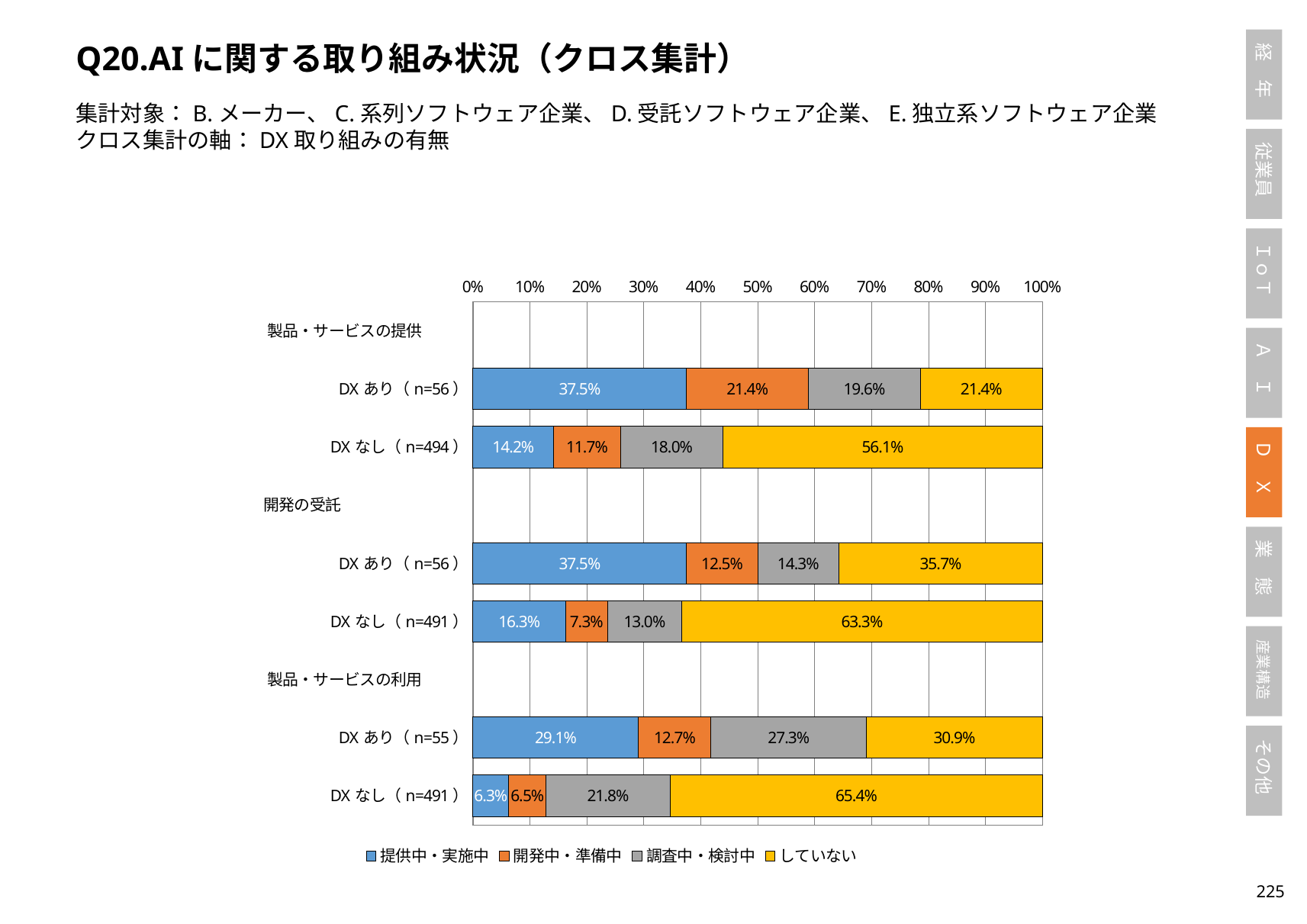
In the 開発の受託 group, what is the 開発中・準備中 value for DX あり (n=56)? 12.5% In the 製品・サービスの提供 group, what is the していない value for DX なし (n=494)? 56.1% In the 製品・サービスの提供 group, what is the 提供中・実施中 value for DX あり (n=56)? 37.5% In the 製品・サービスの利用 group, what is the 調査中・検討中 value for DX あり (n=55)? 27.3% What kind of chart is shown on the slide? stacked bar chart Which row has the lowest 提供中・実施中 value? 製品・サービスの利用 DX なし (n=491) Which row has the highest していない value? 製品・サービスの利用 DX なし (n=491) What colour represents していない in the legend? yellow How many DX あり / DX なし bars are plotted in the chart? 6 How many series does the legend list? 4 In the 製品・サービスの提供 group, which is larger: the 調査中・検討中 value for DX あり (n=56) or for DX なし (n=494)? DX あり (n=56) In the 開発の受託 group, what is the difference between the していない values for DX なし (n=491) and DX あり (n=56)? 27.6%